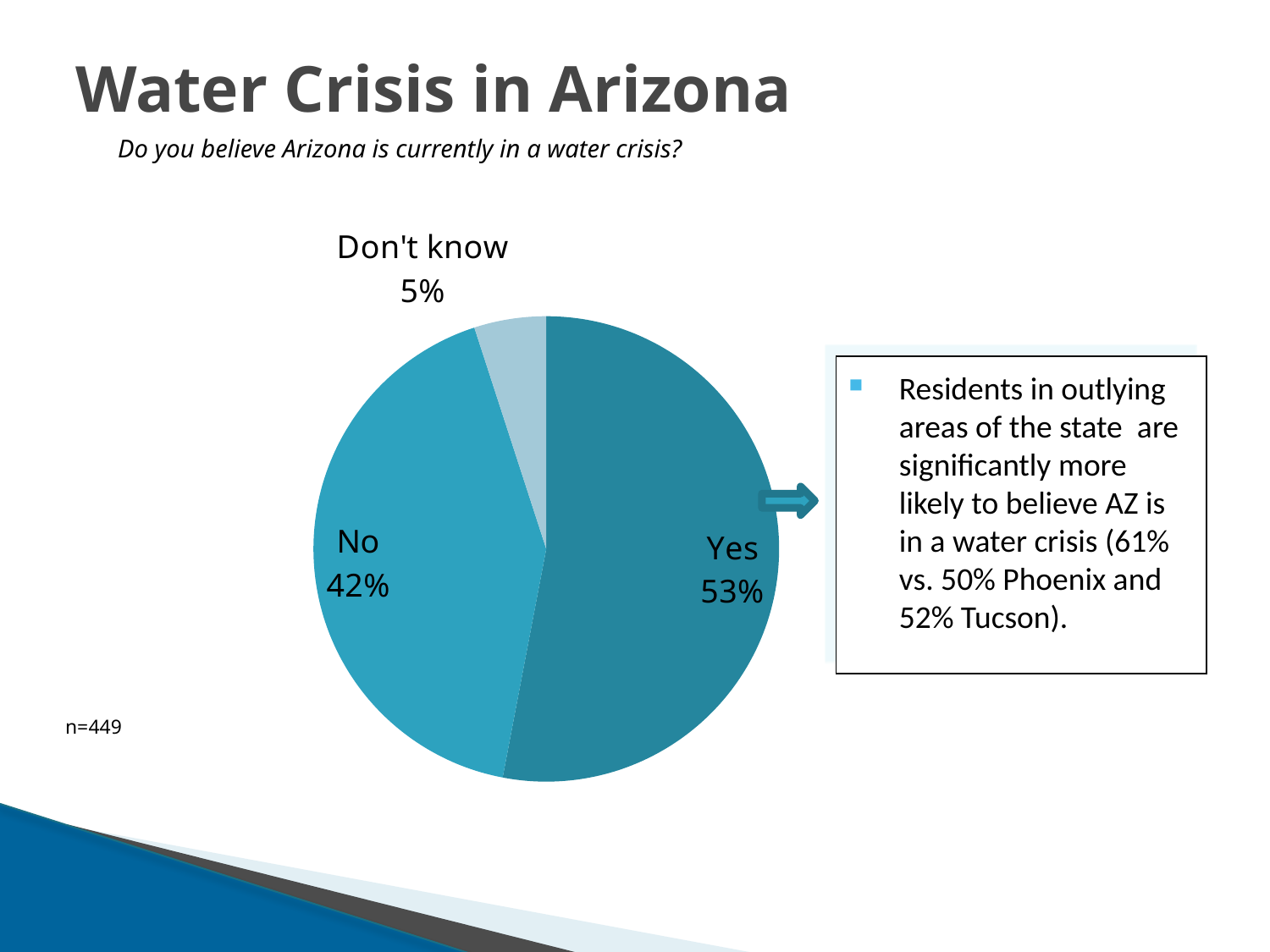
Which slice is larger, No or Don't know? No What percentage of respondents answered No? 42% What percentage of respondents answered Don't know? 5% What survey question does the pie chart answer? Do you believe Arizona is currently in a water crisis? What percentage of respondents answered Yes? 53% What kind of chart is shown on the slide? Pie chart What is the difference in percentage points between the Yes and No slices? 11 How many slices does the pie chart have? 3 Which response has the largest share of the pie? Yes What is the sample size (n) shown on the slide? 449 What share of the pie does the Don't know slice represent? 5% Which response has the smallest share of the pie? Don't know